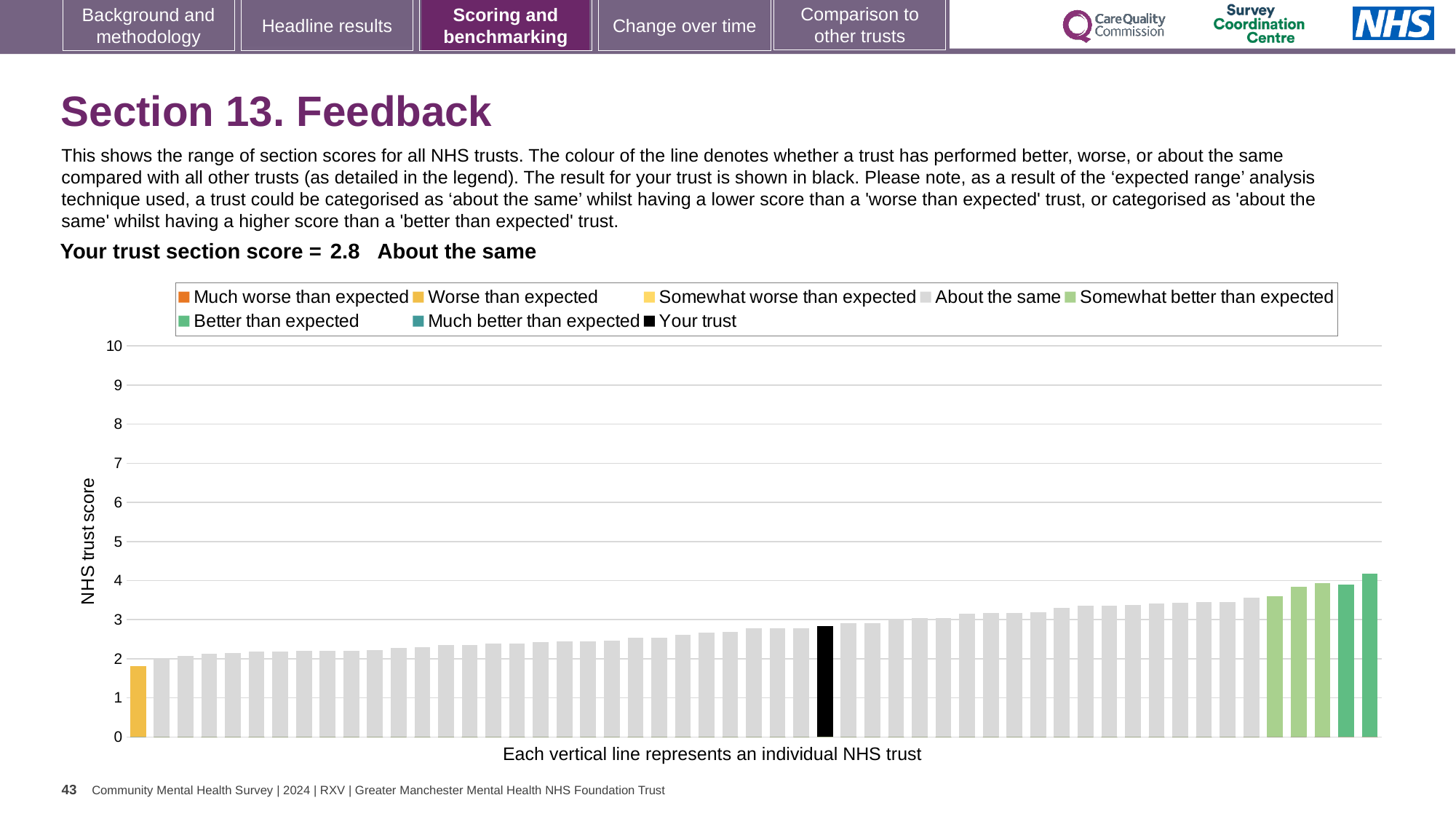
Which is larger: the leftmost bar or the black bar for your trust? the black bar for your trust Is the value for your trust greater or less than 5? less Is the value for the tallest bar greater or less than 5? less Do the bar values rise or fall from left to right along the x axis? rise What is the highest value shown on the vertical axis? 10 Is the value for the leftmost (yellow) bar greater or less than 2? less What is the section score for your trust shown on the slide? 2.8 What colour is the bar representing your trust? black How many bars are coloured yellow (worse than expected)? 1 What kind of chart is shown on the slide? bar chart What is the label on the vertical axis of the chart? NHS trust score How many entries does the chart legend list? 8